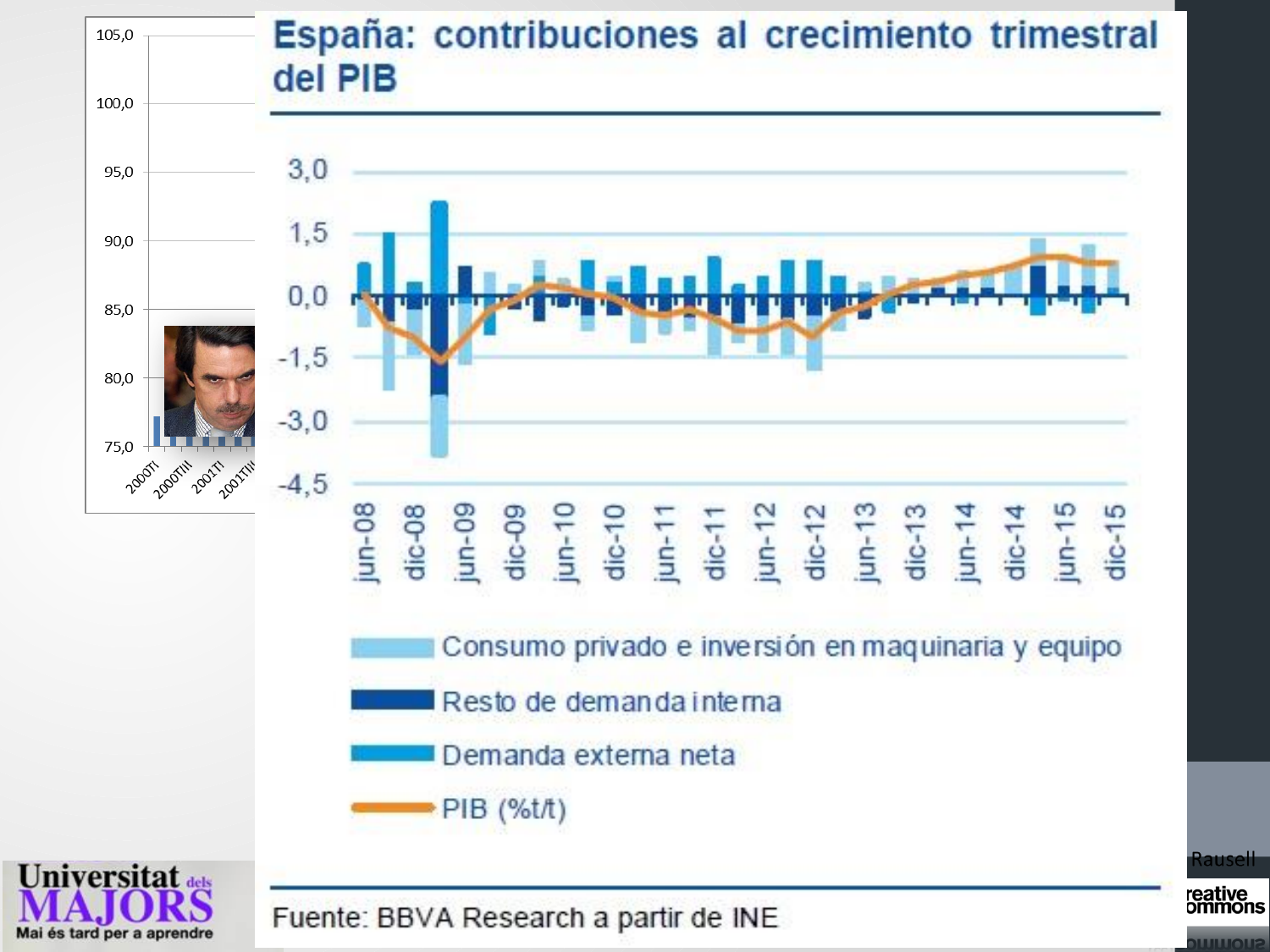
In the chart 'España: contribuciones al crecimiento trimestral del PIB', at which date does the PIB (%t/t) line reach its lowest point? dic-08 What kind of chart is 'España: contribuciones al crecimiento trimestral del PIB'? Stacked bar chart with a line In the chart 'España: contribuciones al crecimiento trimestral del PIB', which series is drawn as an orange line? PIB (%t/t) In the chart 'España: contribuciones al crecimiento trimestral del PIB', is the PIB (%t/t) value at dic-14 larger or smaller than at dic-08? larger In the chart 'España: contribuciones al crecimiento trimestral del PIB', is the PIB (%t/t) line at dic-14 greater or less than 0,0? greater In the chart 'España: contribuciones al crecimiento trimestral del PIB', is the 'Demanda externa neta' bar at dic-08 greater or less than 1,5? greater In the chart 'España: contribuciones al crecimiento trimestral del PIB', is the PIB (%t/t) line at dic-08 greater or less than 0,0? less In the chart 'España: contribuciones al crecimiento trimestral del PIB', how many entries does the legend list? 4 What is the title of the main chart on the slide? España: contribuciones al crecimiento trimestral del PIB In the chart 'España: contribuciones al crecimiento trimestral del PIB', does the PIB (%t/t) line rise or fall between dic-12 and dic-14? rise In the chart 'España: contribuciones al crecimiento trimestral del PIB', how many date labels are shown on the x axis? 16